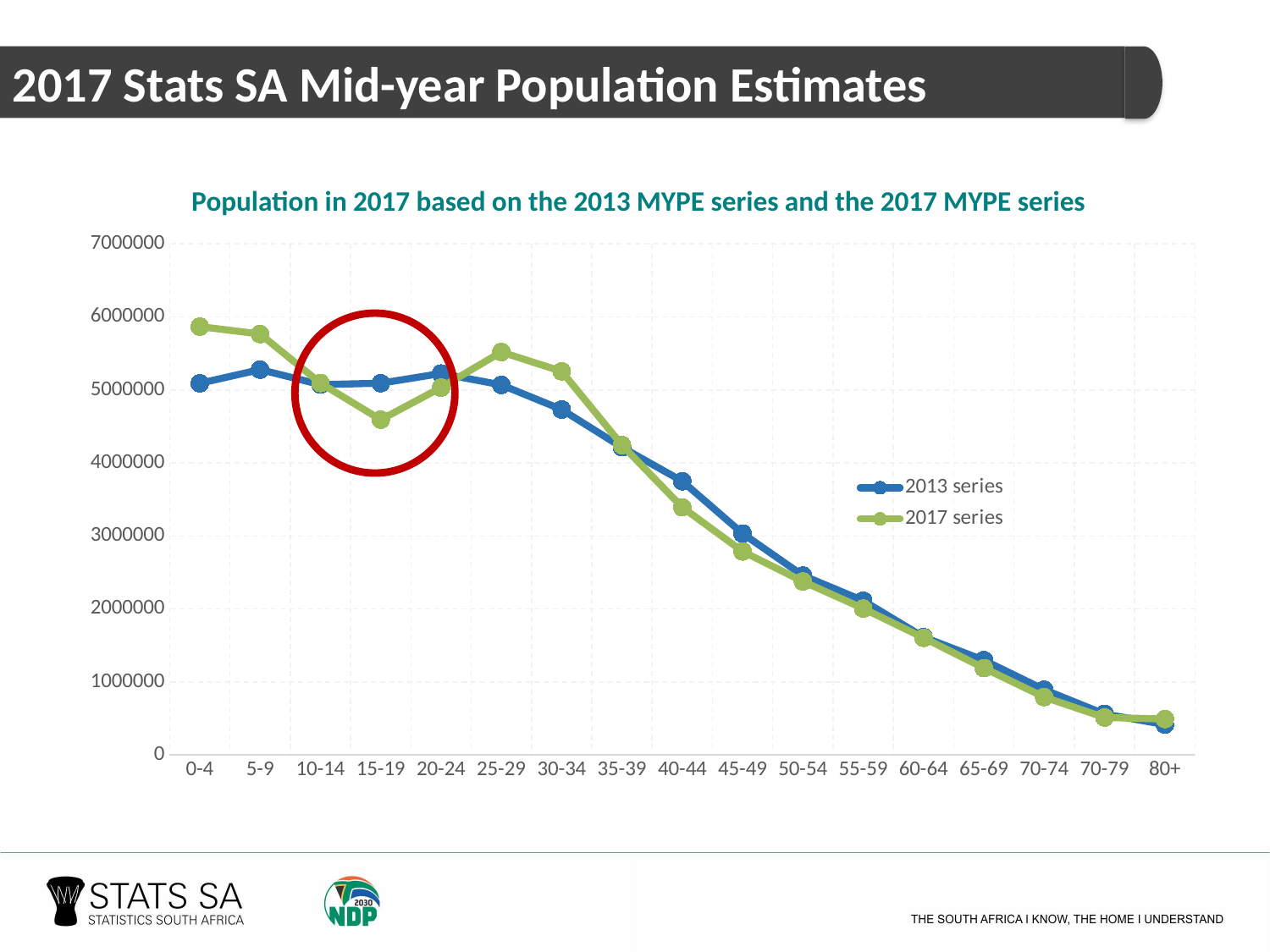
How many series does the legend list? 2 At the 0-4 age group, which series has the larger value, the 2013 series or the 2017 series? 2017 series Which age group has the lowest value for the 2013 series? 80+ Is the value for the 2017 series at 0-4 greater or less than 5000000? greater Is the value for the 2017 series at 15-19 greater or less than 5000000? less Is the value for the 2013 series at 80+ greater or less than 1000000? less At the 15-19 age group, which series has the larger value, the 2013 series or the 2017 series? 2013 series How many age-group categories are shown on the x axis? 17 Which age group has the highest value for the 2017 series? 0-4 What kind of chart is shown on the slide? line chart Do the values of the 2017 series rise or fall from 35-39 to 80+? fall